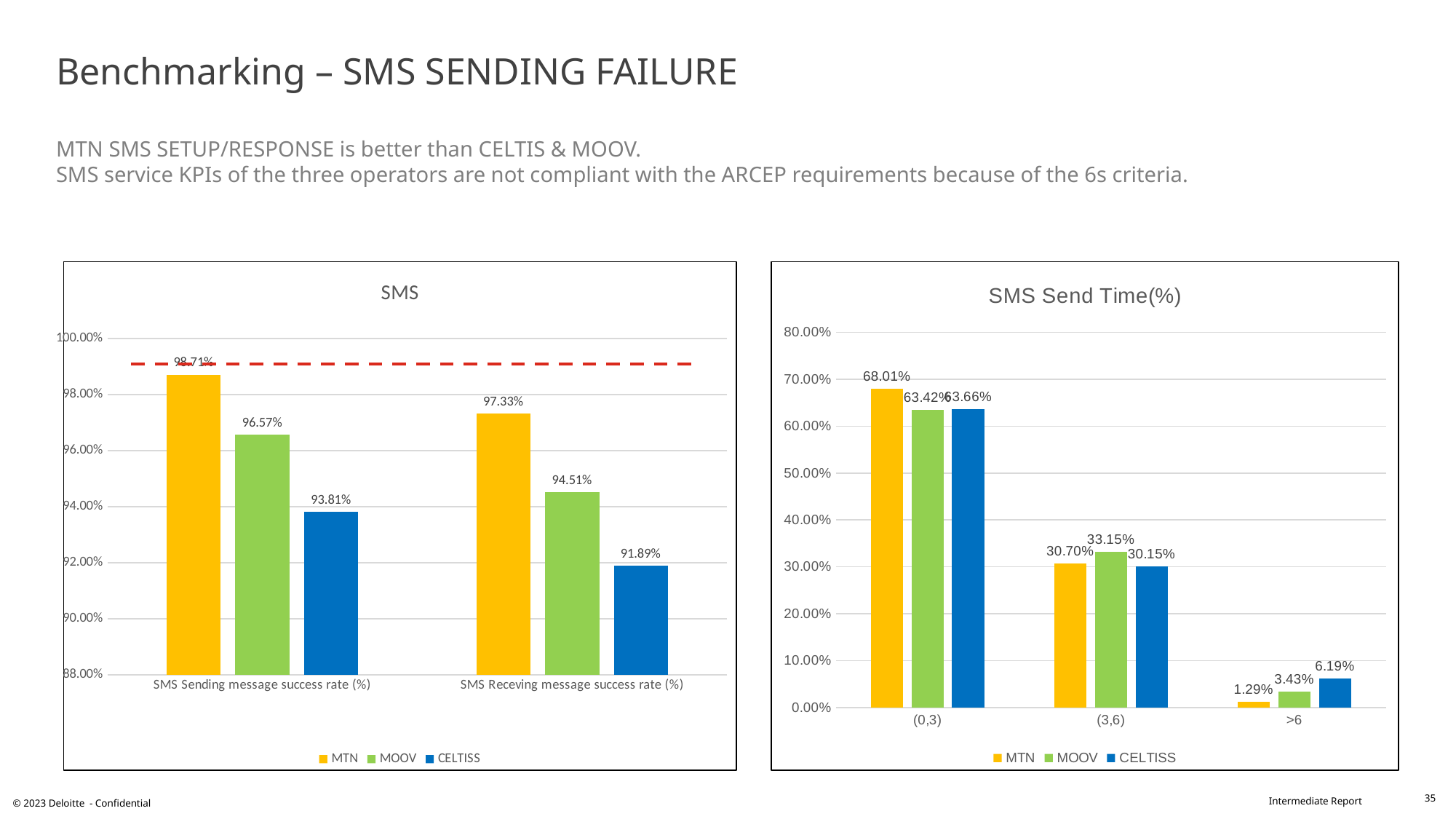
In the SMS chart, is the MTN value for SMS Sending message success rate (%) greater or less than 98.00%? greater In the SMS Send Time(%) chart, what is the value for CELTISS in the >6 category? 6.19% In the SMS Send Time(%) chart, what is the value for MTN in the (0,3) category? 68.01% In the SMS chart, which operator has the lowest SMS Receving message success rate (%)? CELTISS In the SMS chart, what is the SMS Sending message success rate (%) for MOOV? 96.57% In the SMS Send Time(%) chart, which is larger in the (0,3) category: MTN or MOOV? MTN How many series does the legend of the SMS Send Time(%) chart list? 3 In the SMS chart, what is the difference between MTN and MOOV for SMS Receving message success rate (%)? 2.82% In the SMS chart, what is the SMS Receving message success rate (%) for CELTISS? 91.89% In the SMS Send Time(%) chart, what is the difference between CELTISS and MTN in the >6 category? 4.90% What kind of chart is the SMS chart? bar chart In the SMS Send Time(%) chart, which operator has the highest value in the (3,6) category? MOOV